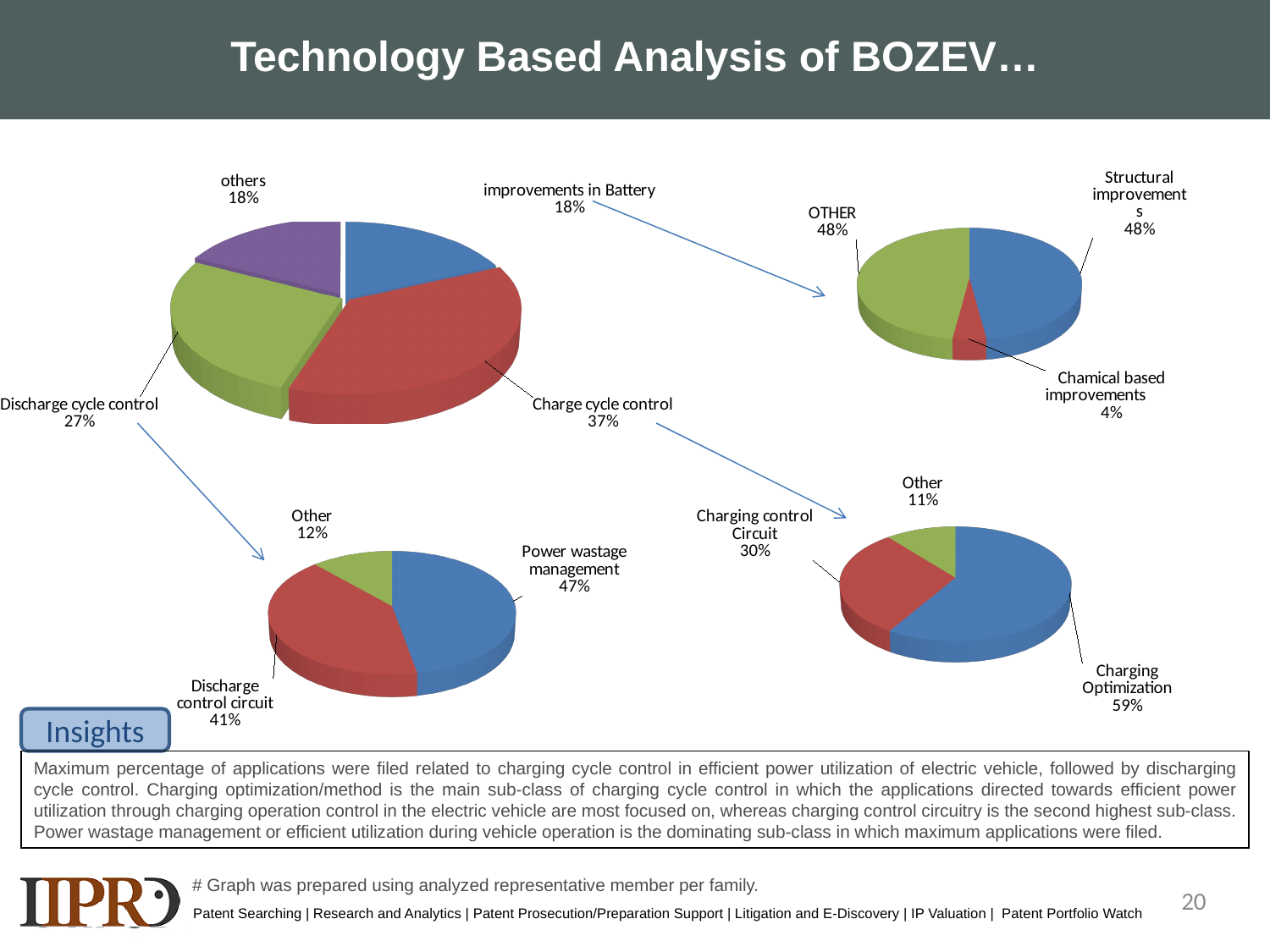
In the large pie chart at the top left, what share is labelled for Charge cycle control? 37% In the large pie chart at the top left, which category has the largest share? Charge cycle control What type of chart is used for the bottom right chart? Pie chart In the pie chart at the bottom left, what share is labelled for Power wastage management? 47% How many slices does the large pie chart at the top left have? 4 In the pie chart at the bottom right, what is the difference between the shares for Charging Optimization and Charging control Circuit? 29% How many pie charts are shown on the slide? 4 In the large pie chart at the top left, what is the difference between the shares for Charge cycle control and Discharge cycle control? 10% In the pie chart at the bottom right, what share is labelled for Charging Optimization? 59% In the pie chart at the top right, which category has the smallest share? Chamical based improvements In the pie chart at the top right, what share is labelled for Chamical based improvements? 4% In the pie chart at the bottom left, which is larger: Power wastage management or Discharge control circuit? Power wastage management